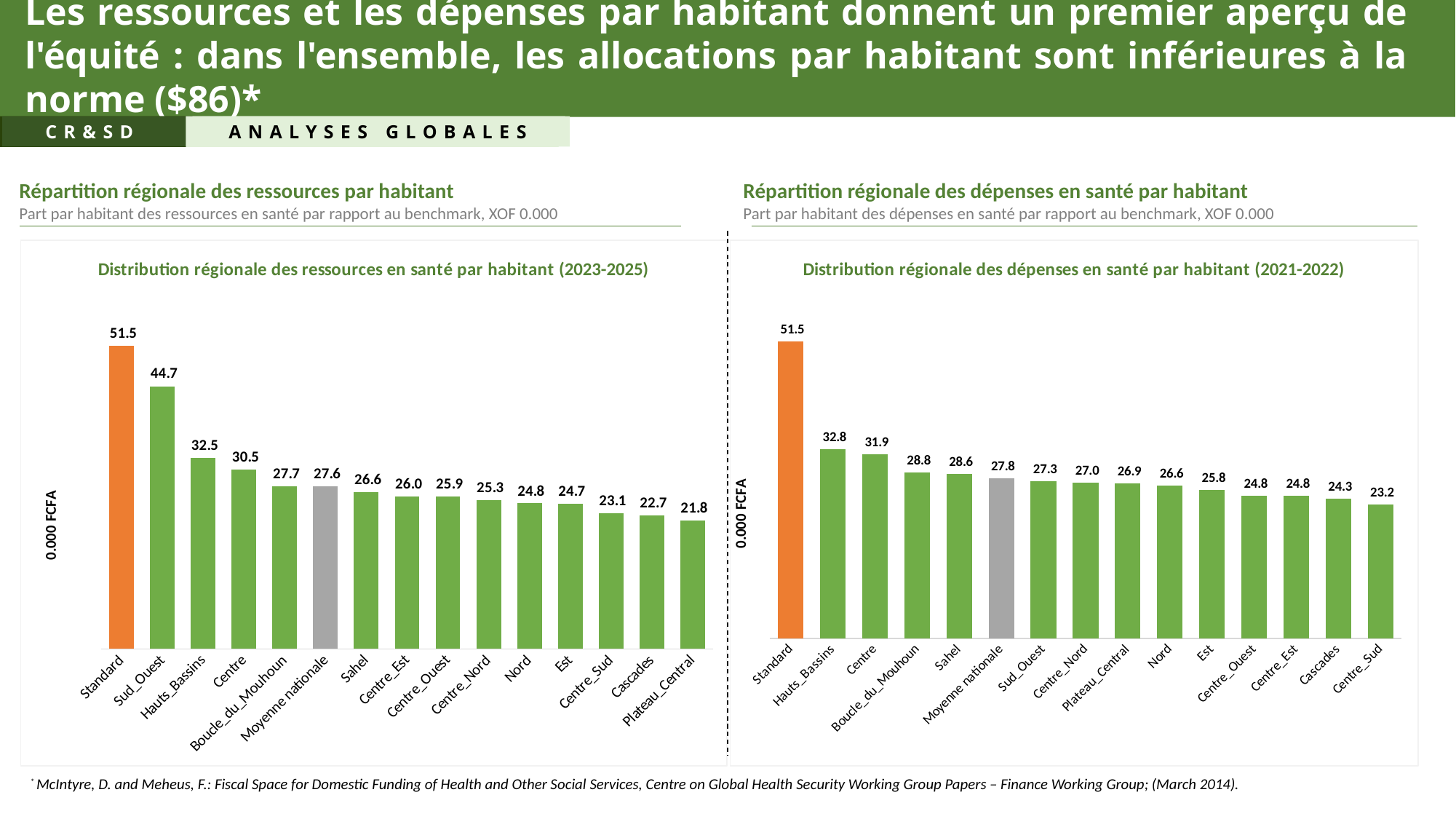
In the left chart (ressources en santé par habitant), how many bars are plotted? 15 In the right chart (dépenses en santé par habitant), what colour is the Standard bar? Orange What type of chart is used in the left chart (ressources en santé par habitant)? Bar chart In the left chart (ressources en santé par habitant), which region has the lowest value? Plateau_Central In the right chart (dépenses en santé par habitant), which bar is the highest? Standard In the right chart (dépenses en santé par habitant), which is larger, Centre or Sahel? Centre In the right chart (dépenses en santé par habitant), what is the value for Centre_Sud? 23.2 In the left chart (ressources en santé par habitant), what is the value for Moyenne nationale? 27.6 In the left chart (Distribution régionale des ressources en santé par habitant 2023-2025), what is the value for Sud_Ouest? 44.7 In the left chart (ressources en santé par habitant), what is the difference between Standard and Sud_Ouest? 6.8 In the right chart (dépenses en santé par habitant), what is the difference between Moyenne nationale and Cascades? 3.5 In the right chart (Distribution régionale des dépenses en santé par habitant 2021-2022), what is the value for Hauts_Bassins? 32.8